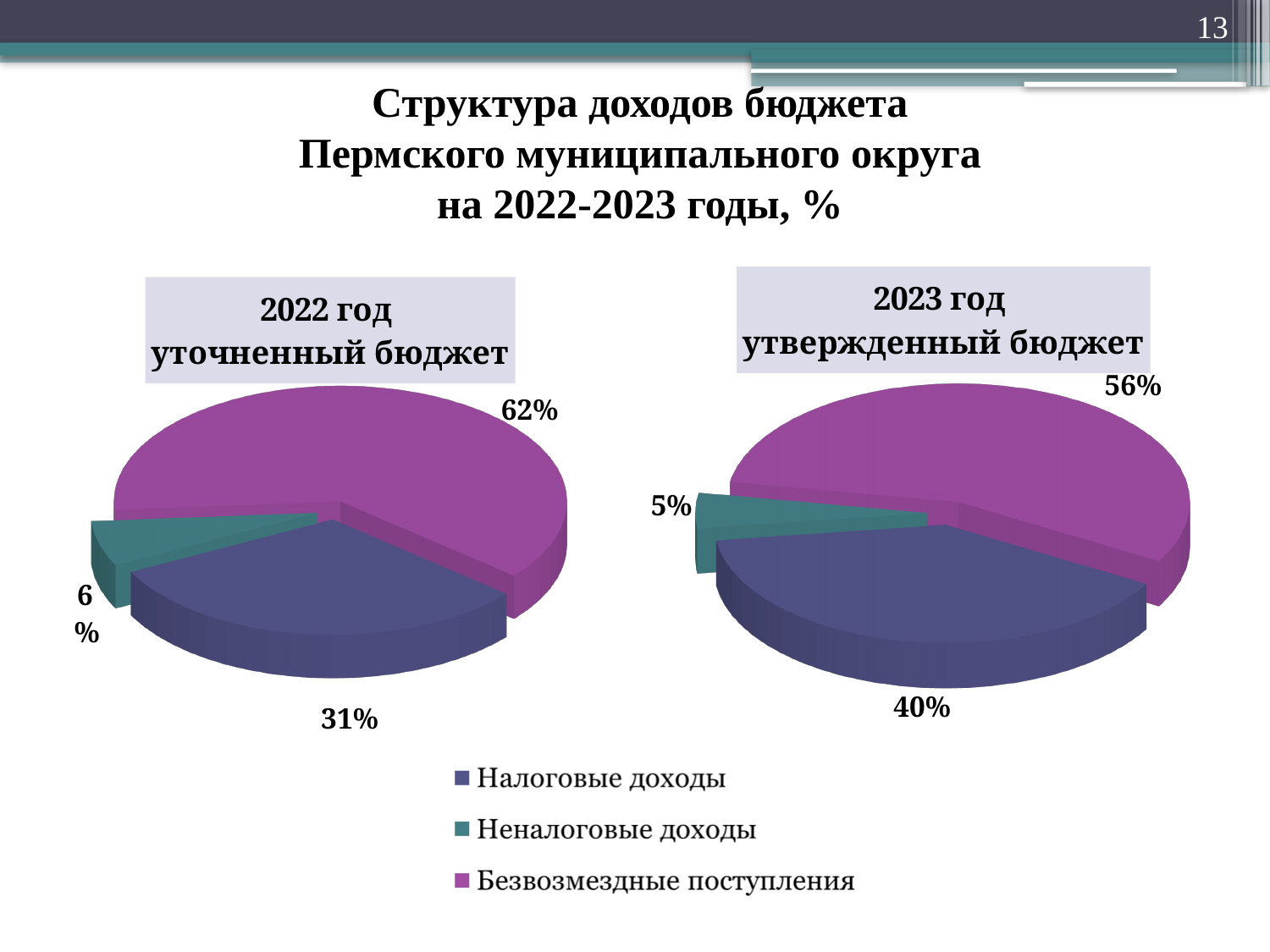
In the '2022 год уточненный бюджет' chart, what share is shown for Налоговые доходы? 31% In the '2023 год утвержденный бюджет' chart, what share is shown for Налоговые доходы? 40% In the '2023 год утвержденный бюджет' chart, which category has the largest slice? Безвозмездные поступления What type of chart is used on this slide? Pie chart In the '2022 год уточненный бюджет' chart, what share is shown for Неналоговые доходы? 6% In the '2022 год уточненный бюджет' chart, which category has the smallest slice? Неналоговые доходы What is the difference between the share of Налоговые доходы in the '2023 год утвержденный бюджет' chart and in the '2022 год уточненный бюджет' chart? 9% In the '2022 год уточненный бюджет' chart, what share is shown for Безвозмездные поступления? 62% In the '2023 год утвержденный бюджет' chart, what share is shown for Безвозмездные поступления? 56% In the '2023 год утвержденный бюджет' chart, what share is shown for Неналоговые доходы? 5% How many categories does the legend list? 3 Which chart shows a larger share for Безвозмездные поступления, '2022 год уточненный бюджет' or '2023 год утвержденный бюджет'? 2022 год уточненный бюджет